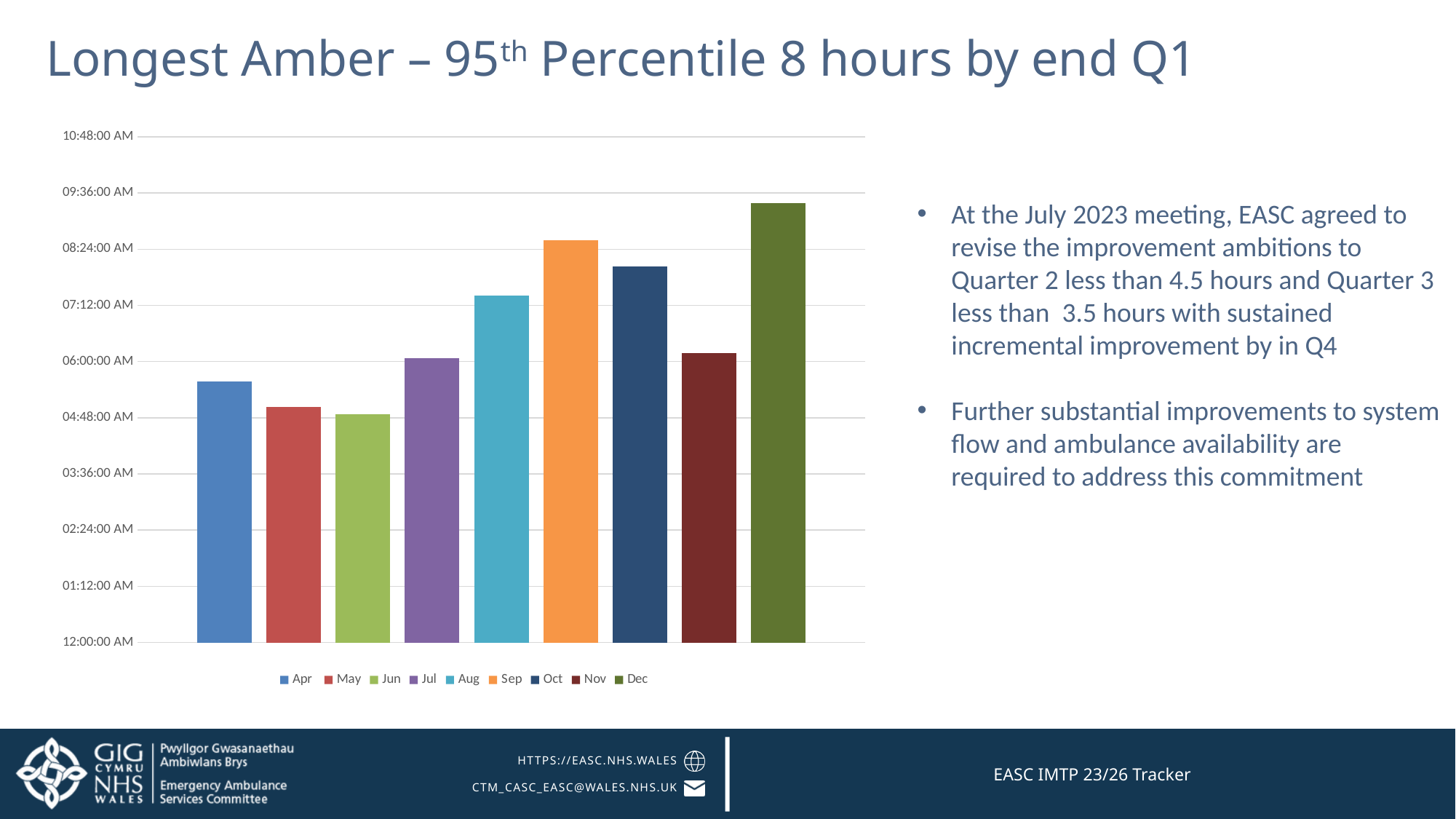
Is the value for Apr greater or less than 06:00:00 AM? less How many bars (months) are plotted in the chart? 9 Which month has the highest value in the chart? Dec Which month has the lowest value in the chart? Jun Is the value for Sep greater or less than 08:24:00 AM? greater Do the values rise or fall from Jun through Sep? rise Which is larger, the value for Aug or the value for Jul? Aug Is the value for Dec greater or less than 09:36:00 AM? less What kind of chart is shown on the slide? bar chart What is the title of the slide containing the chart? Longest Amber – 95th Percentile 8 hours by end Q1 Which is larger, the value for Sep or the value for Oct? Sep How many entries does the chart legend list? 9